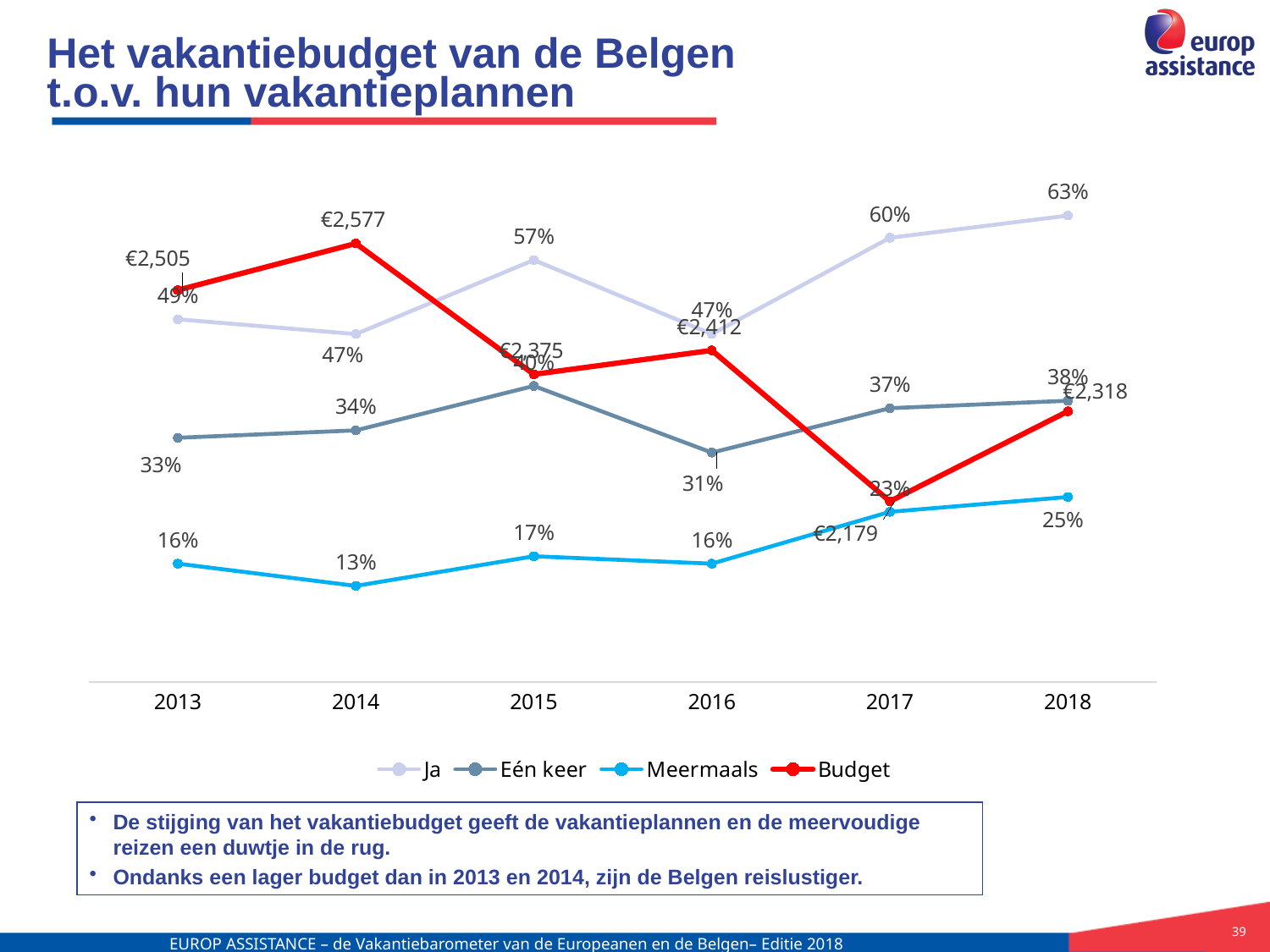
In which year is the Budget series at its highest? 2014 In which year is the Ja series at its highest? 2018 How many years are shown on the x axis? 6 What is the value for the Ja series in 2018? 63% What is the difference between the Ja value in 2018 and in 2013? 14 percentage points What is the value for Meermaals in 2014? 13% Which is larger for the Eén keer series: the value in 2016 or in 2017? 2017 How many series does the legend list? 4 What is the Budget value in 2014? €2,577 Does the Meermaals series rise or fall from 2016 to 2018? rise In which year is the Budget series at its lowest? 2017 What kind of chart is shown on the slide? line chart